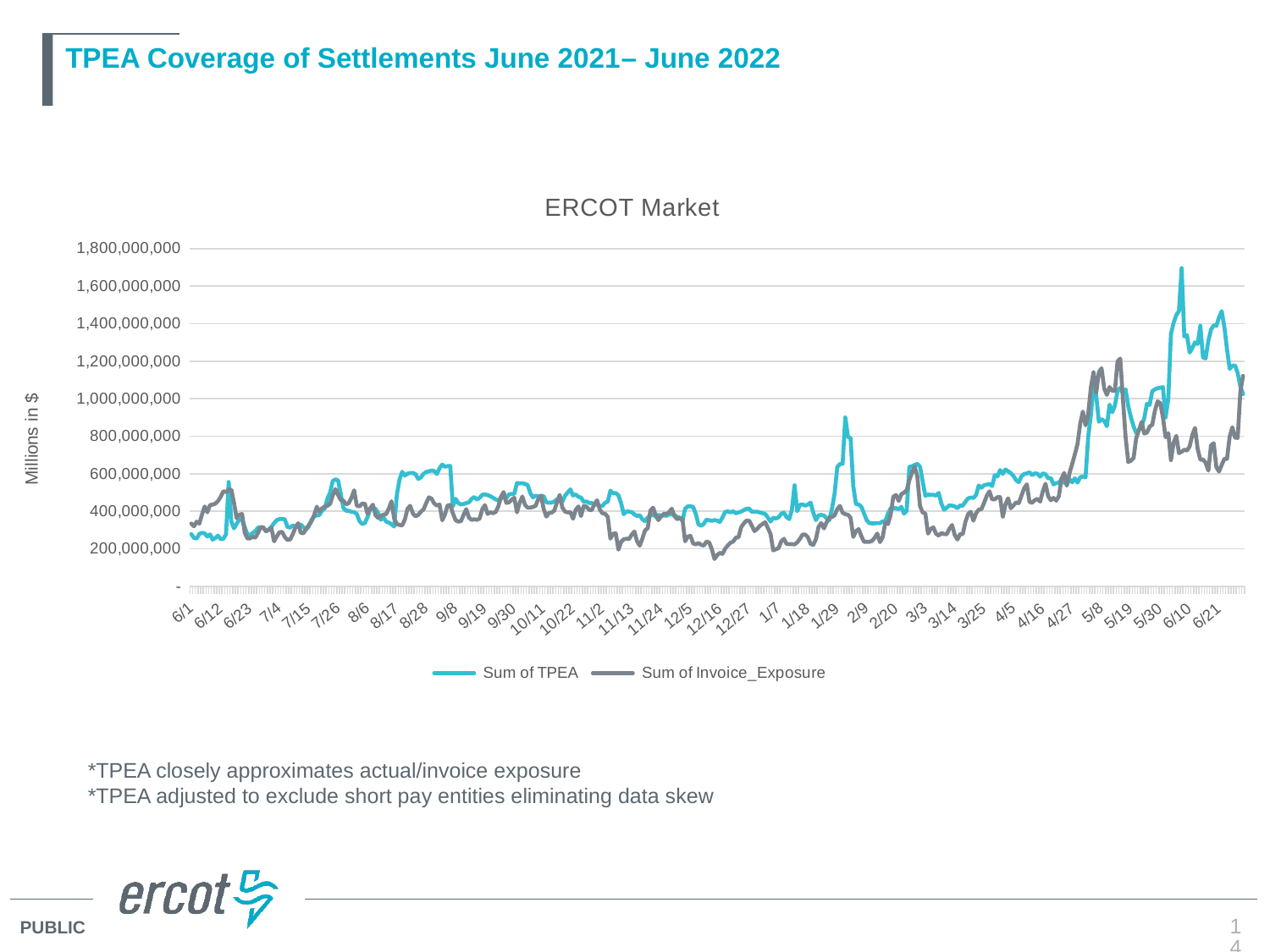
Which series reaches the higher peak value over the period, Sum of TPEA or Sum of Invoice_Exposure? Sum of TPEA What kind of chart is shown on the slide? line chart What is the highest value shown on the vertical axis? 1,800,000,000 What is the title of the chart? ERCOT Market Overall, do the values of Sum of TPEA rise or fall from June 2021 to June 2022? rise Is the peak value of Sum of Invoice_Exposure greater or less than 1,400,000,000? less Is the peak value of Sum of TPEA (around 6/10) greater or less than 1,600,000,000? greater Is the lowest value of Sum of Invoice_Exposure (around 12/16) greater or less than 200,000,000? less What is the label on the vertical axis of the chart? Millions in $ How many series does the legend list? 2